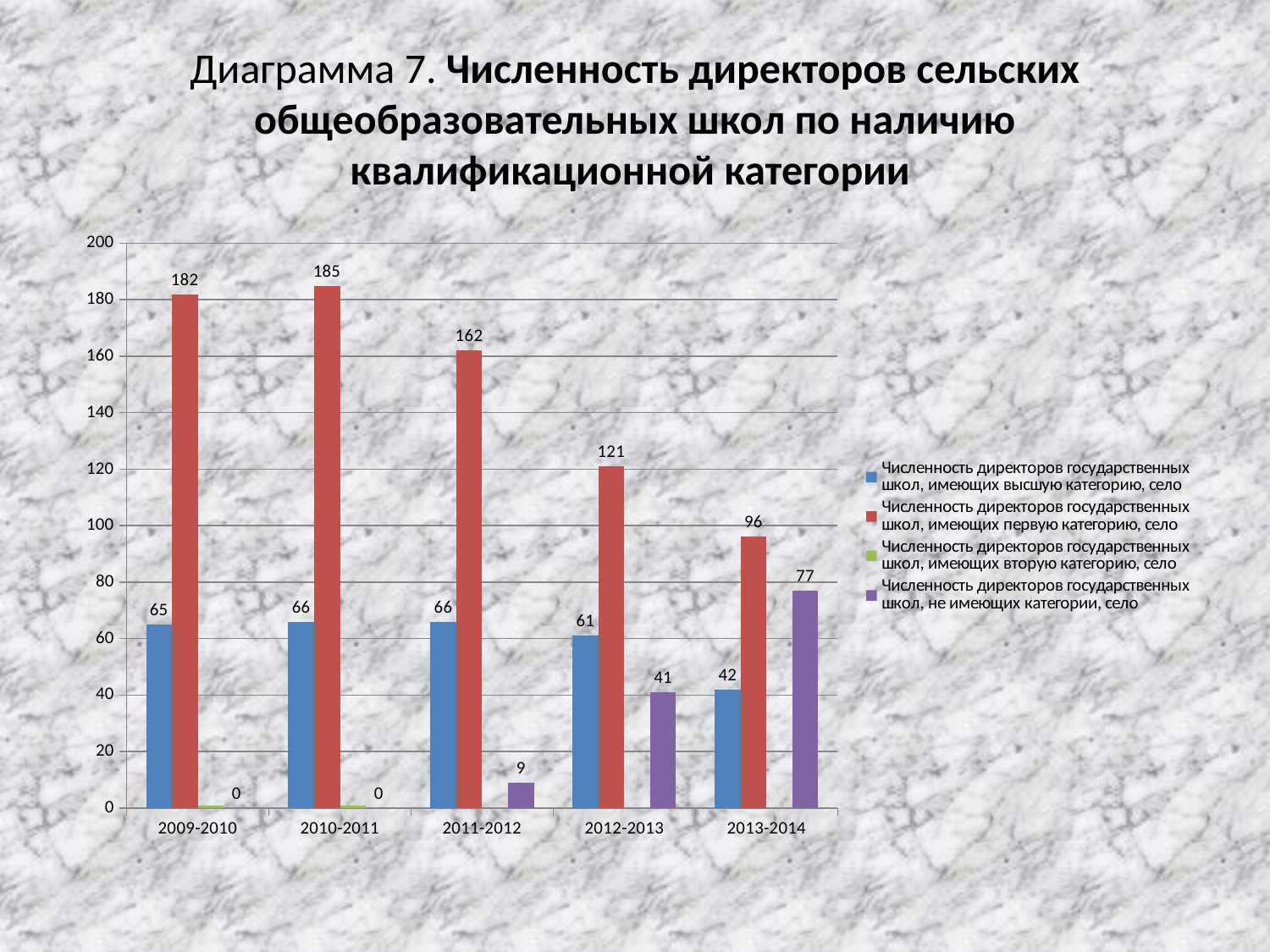
In which academic year is the number of directors with the first category (первую категорию) the highest? 2010-2011 What is the difference between the number of directors with the first category in 2009-2010 and in 2013-2014? 86 What is the number of directors without a category (не имеющих категории) in 2012-2013? 41 How many series does the legend list? 4 Which is larger in 2013-2014: the number of directors with the first category or the number without a category? first category (96) How does the number of directors with the first category (первую категорию) change from 2010-2011 to 2013-2014? it falls What type of chart is shown on the slide? bar chart How many academic-year categories are shown on the x axis? 5 What is the number of directors with the first category (первую категорию) in 2010-2011? 185 What is the number of directors with the highest category (высшую категорию) in 2013-2014? 42 In which academic year is the number of directors with the highest category (высшую категорию) the lowest? 2013-2014